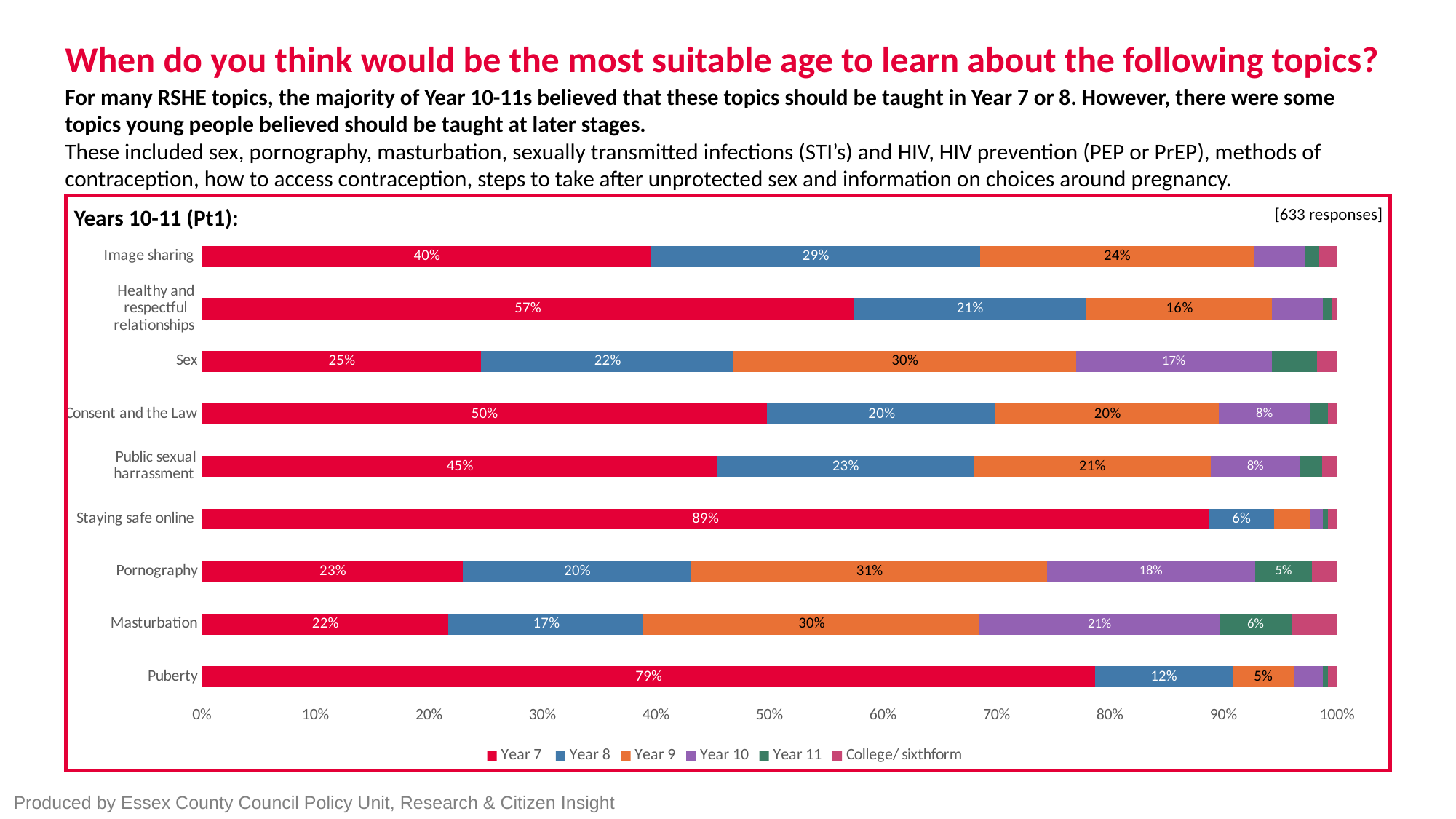
What is the Year 8 value for Image sharing? 29% What is the Year 9 value for Pornography? 31% What percentage of Year 10-11 respondents said Year 7 was the most suitable age to learn about Staying safe online? 89% Is the Year 7 value for Puberty greater or less than 70%? greater Which topic has the highest Year 7 value? Staying safe online Which topic has the lowest Year 7 value? Masturbation Which has a larger Year 9 value, Sex or Consent and the Law? Sex What is the difference in percentage points between the Year 7 values for Healthy and respectful relationships and Image sharing? 17 percentage points What kind of chart is shown on the slide? Stacked bar chart How many series does the legend list? 6 What is the Year 10 value for Masturbation? 21% How many topics are shown on the chart? 9